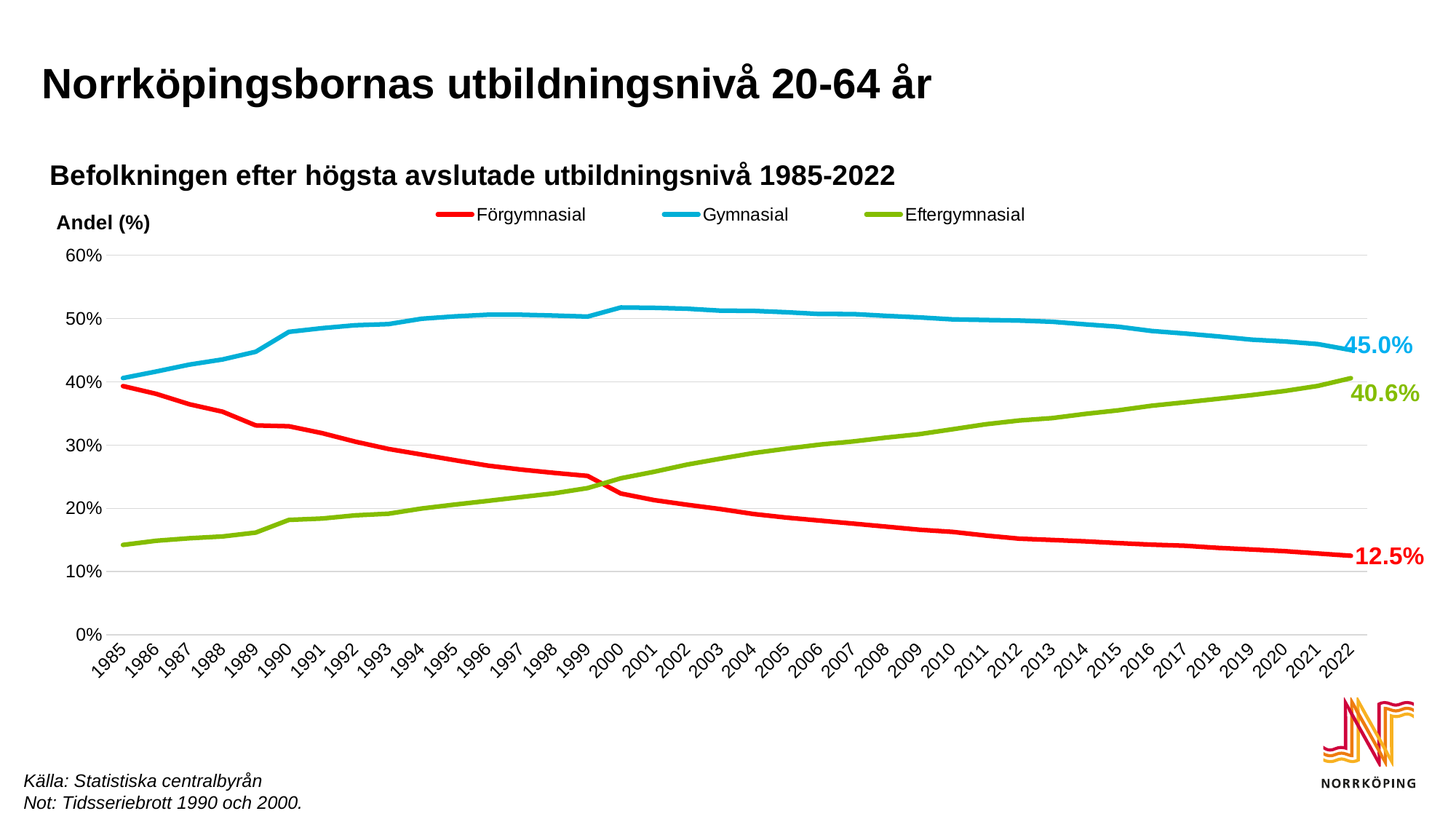
Does the Förgymnasial series rise or fall from 1985 to 2022? fall Which series has the highest value in 2022? Gymnasial What is the value for Gymnasial in 2022? 45.0% Which series has the lowest value in 2022? Förgymnasial How many series does the legend list? 3 Is the value for Förgymnasial in 1985 greater or less than 30%? greater What is the difference between the Gymnasial and Eftergymnasial values in 2022? 4.4% What is the value for Förgymnasial in 2022? 12.5% What kind of chart is shown on the slide? line chart Which colour is used for the Eftergymnasial series? green What is the value for Eftergymnasial in 2022? 40.6% Does the Eftergymnasial series rise or fall from 1985 to 2022? rise